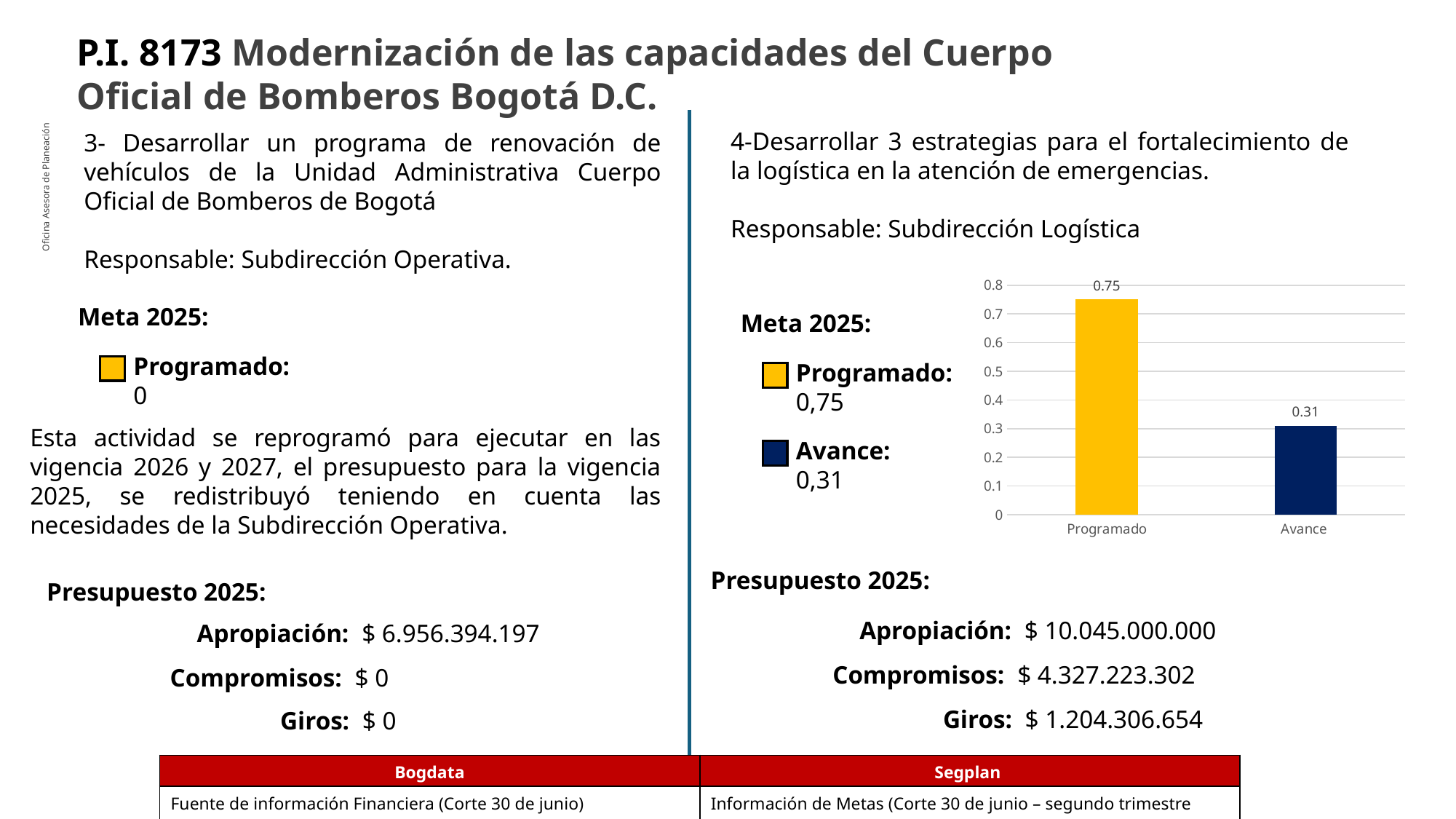
Is the value for Avance in the chart greater or less than 0.4? less How many bars are plotted in the chart? 2 What kind of chart is shown on the slide? bar chart Which bar in the chart is the lowest? Avance Which bar in the chart is the highest? Programado Is the value for Programado in the chart greater or less than 0.7? greater What colour is the Avance bar in the chart? dark blue What is the value of the Avance bar in the chart? 0.31 What is the difference between the Programado and Avance values in the chart? 0.44 What is the highest value shown on the chart's vertical axis? 0.8 What is the value of the Programado bar in the chart? 0.75 Which is larger in the chart, Programado or Avance? Programado